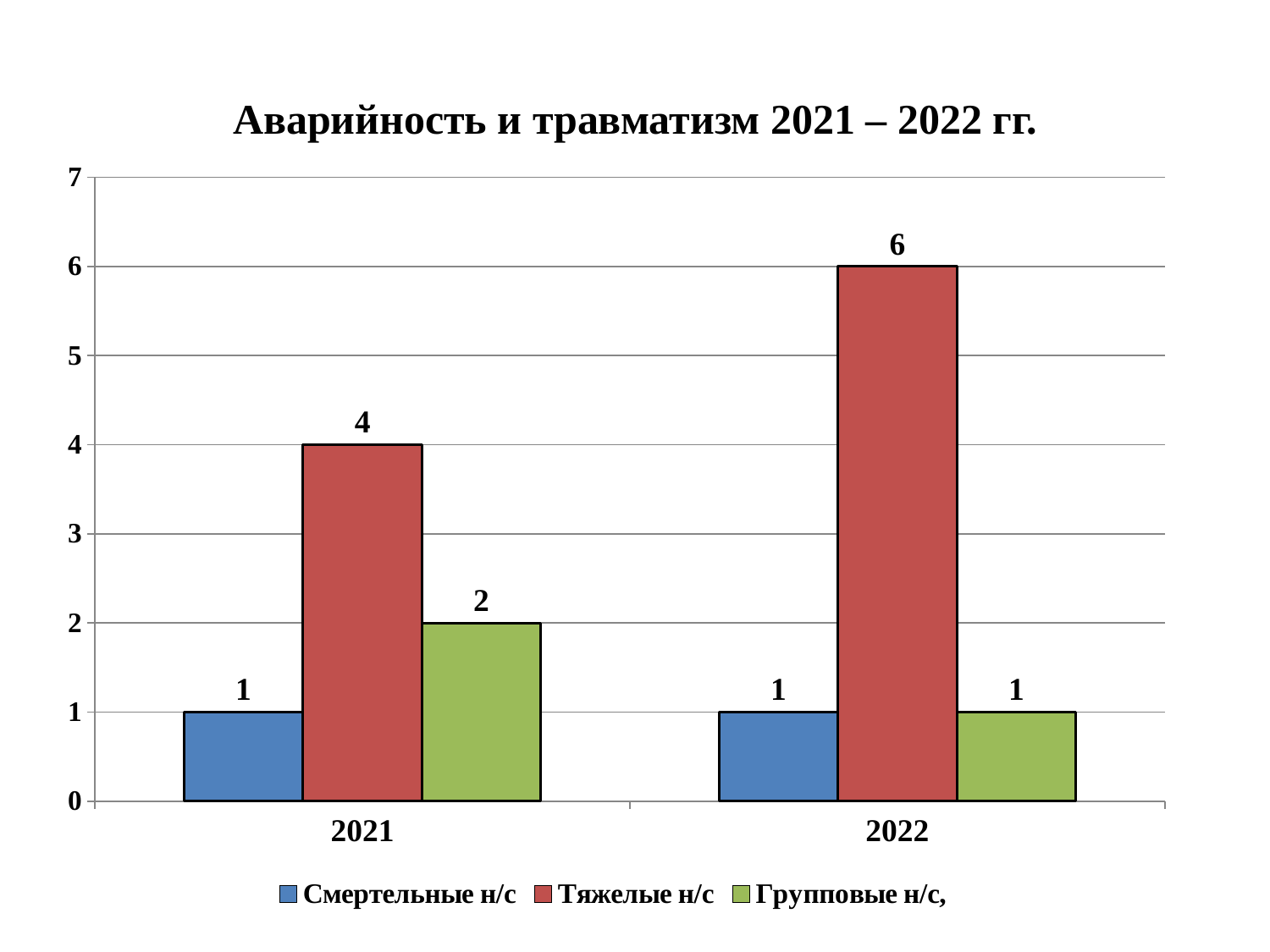
What is the value for Тяжелые н/с in 2022? 6 What kind of chart is shown on the slide? Bar chart How many year categories are shown on the x axis? 2 Which is larger: Групповые н/с in 2021 or Групповые н/с in 2022? Групповые н/с in 2021 Which series has the highest value in 2022? Тяжелые н/с What is the difference between the Тяжелые н/с values for 2022 and 2021? 2 Which series has the lowest value in 2021? Смертельные н/с What is the value for Групповые н/с in 2021? 2 How many series does the legend list? 3 What is the title of the chart? Аварийность и травматизм 2021 – 2022 гг. What is the value for Тяжелые н/с in 2021? 4 What is the value for Смертельные н/с in 2022? 1